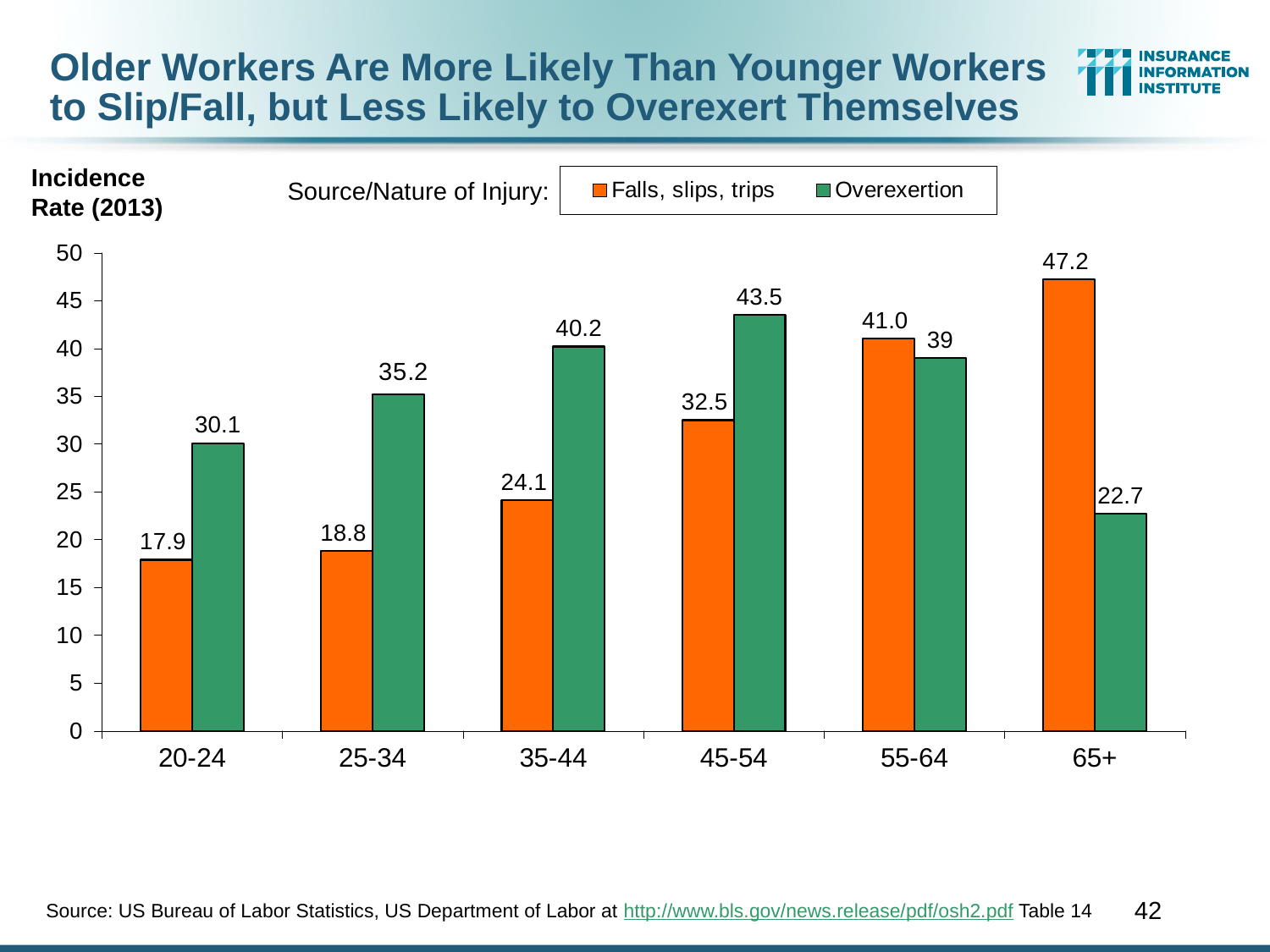
Which age group has the highest incidence rate for Overexertion? 45-54 Which age group has the lowest incidence rate for Falls, slips, trips? 20-24 Do the Falls, slips, trips incidence rates rise or fall as age group increases along the x axis? Rise What kind of chart is shown on the slide? Bar chart How many series does the legend list? 2 What is the incidence rate for Overexertion in the 25-34 age group? 35.2 What is the incidence rate for Falls, slips, trips in the 20-24 age group? 17.9 How many age groups are shown on the x axis? 6 Is the Overexertion incidence rate for the 55-64 age group greater or less than 35? greater What is the incidence rate for Falls, slips, trips in the 65+ age group? 47.2 In the 35-44 age group, which is larger: the Falls, slips, trips rate or the Overexertion rate? Overexertion What is the difference between the Falls, slips, trips rate and the Overexertion rate in the 65+ age group? 24.5